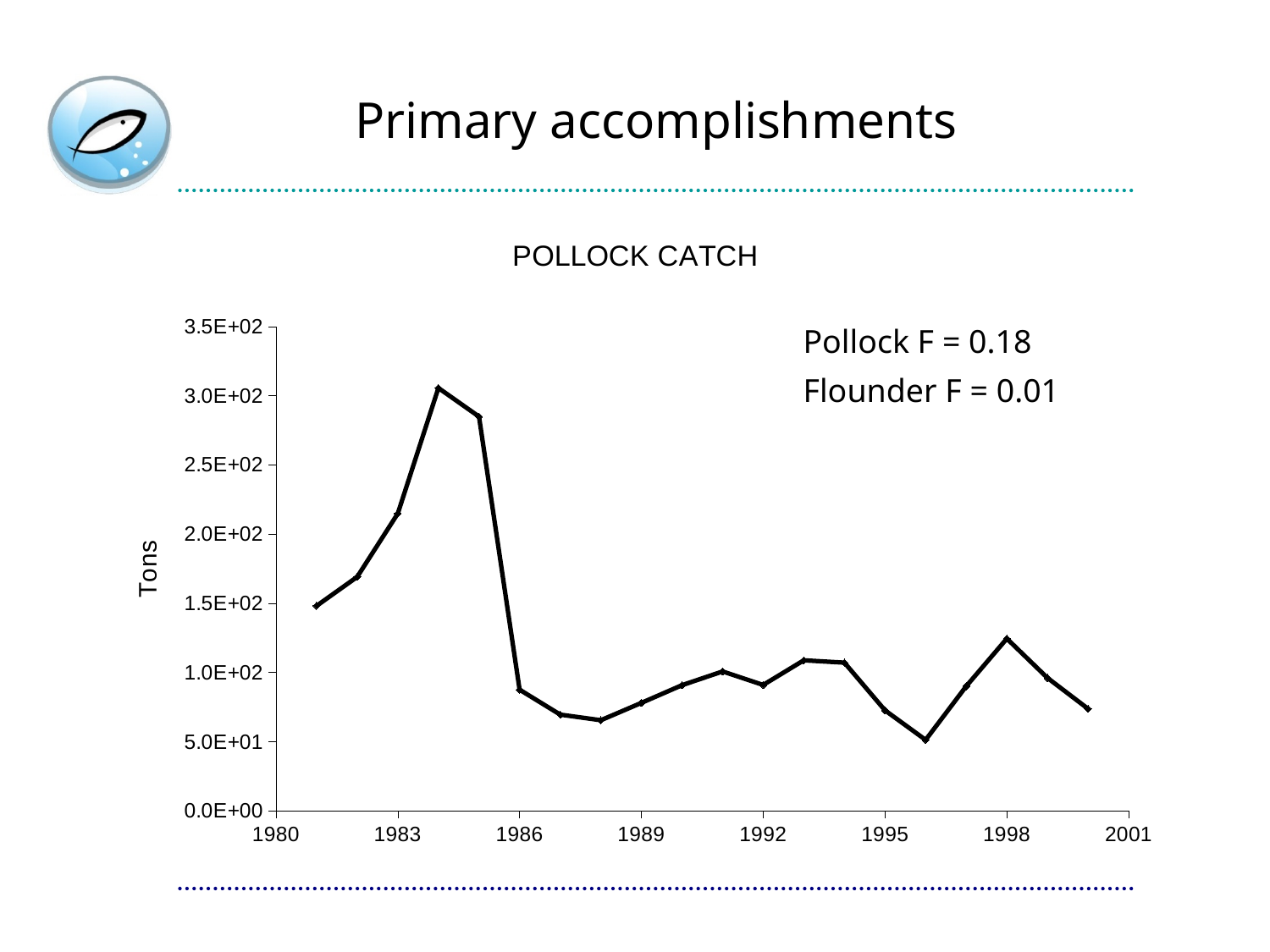
What kind of chart is shown on the slide? Line chart Is the value for 1984 greater or less than 2.5E+02? greater Is the value for 1998 greater or less than 1.0E+02? greater Which year has the larger pollock catch, 1983 or 1989? 1983 What is the label on the y axis of the chart? Tons Which year has the larger pollock catch, 1996 or 1998? 1998 What is the title of the chart? POLLOCK CATCH In which year does the pollock catch reach its highest value? 1984 Does the pollock catch rise or fall between 1984 and 1986? Fall Is the value for 1981 greater or less than 2.0E+02? less In which year does the pollock catch reach its lowest value? 1996